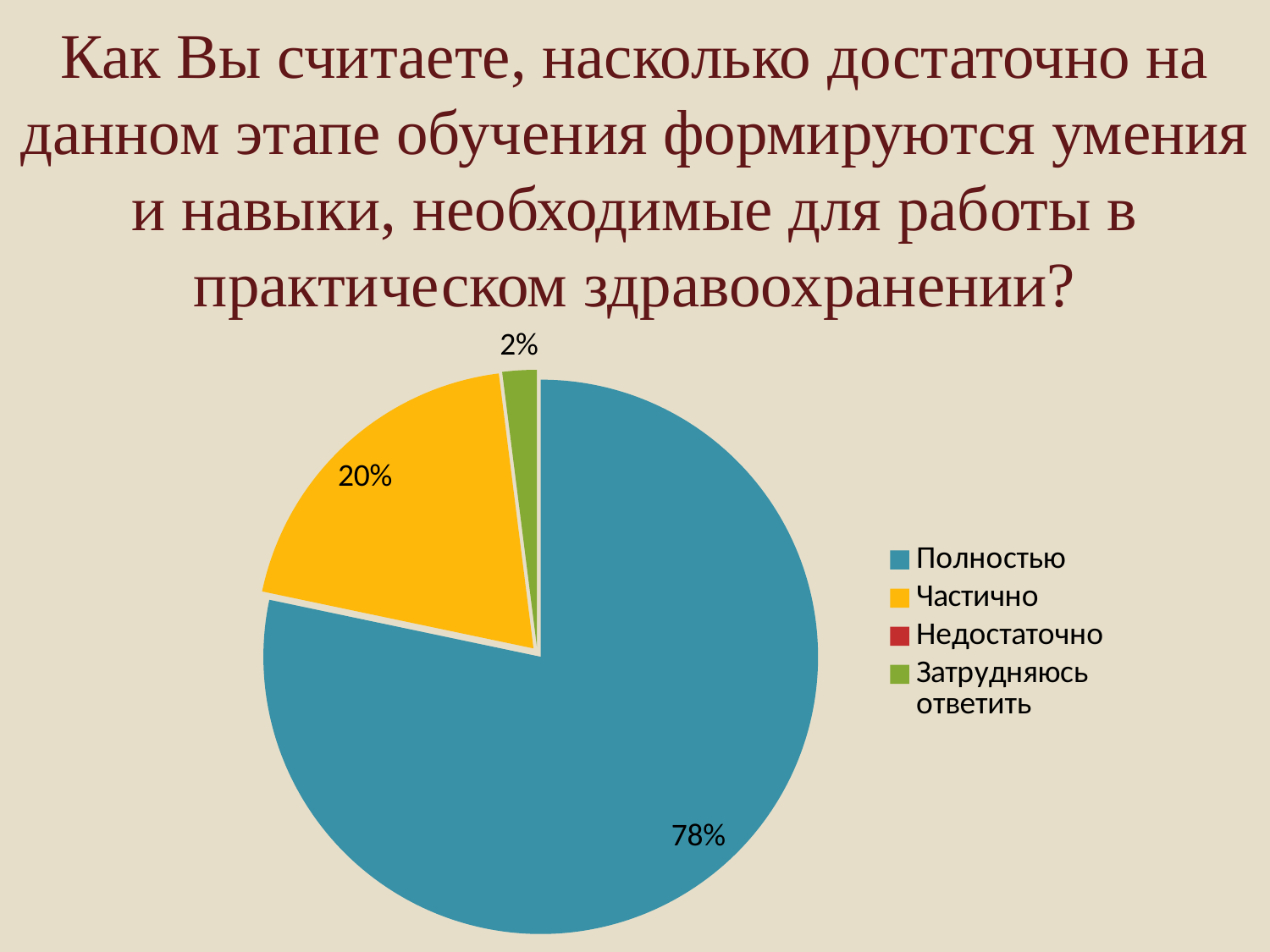
Which legend entry is shown in red? Недостаточно Which category has the largest slice of the pie? Полностью What is the difference in percentage points between "Полностью" and "Частично"? 58 How many entries does the legend list? 4 What share of the pie does "Частично" have? 20% What kind of chart is shown on the slide? pie chart Which labelled slice of the pie is the smallest? Затрудняюсь ответить What colour is the slice for "Полностью"? blue What is the difference in percentage points between "Частично" and "Затрудняюсь ответить"? 18 Which is larger, the slice for "Частично" or the slice for "Затрудняюсь ответить"? Частично What share of the pie does "Полностью" have? 78% What share of the pie does "Затрудняюсь ответить" have? 2%